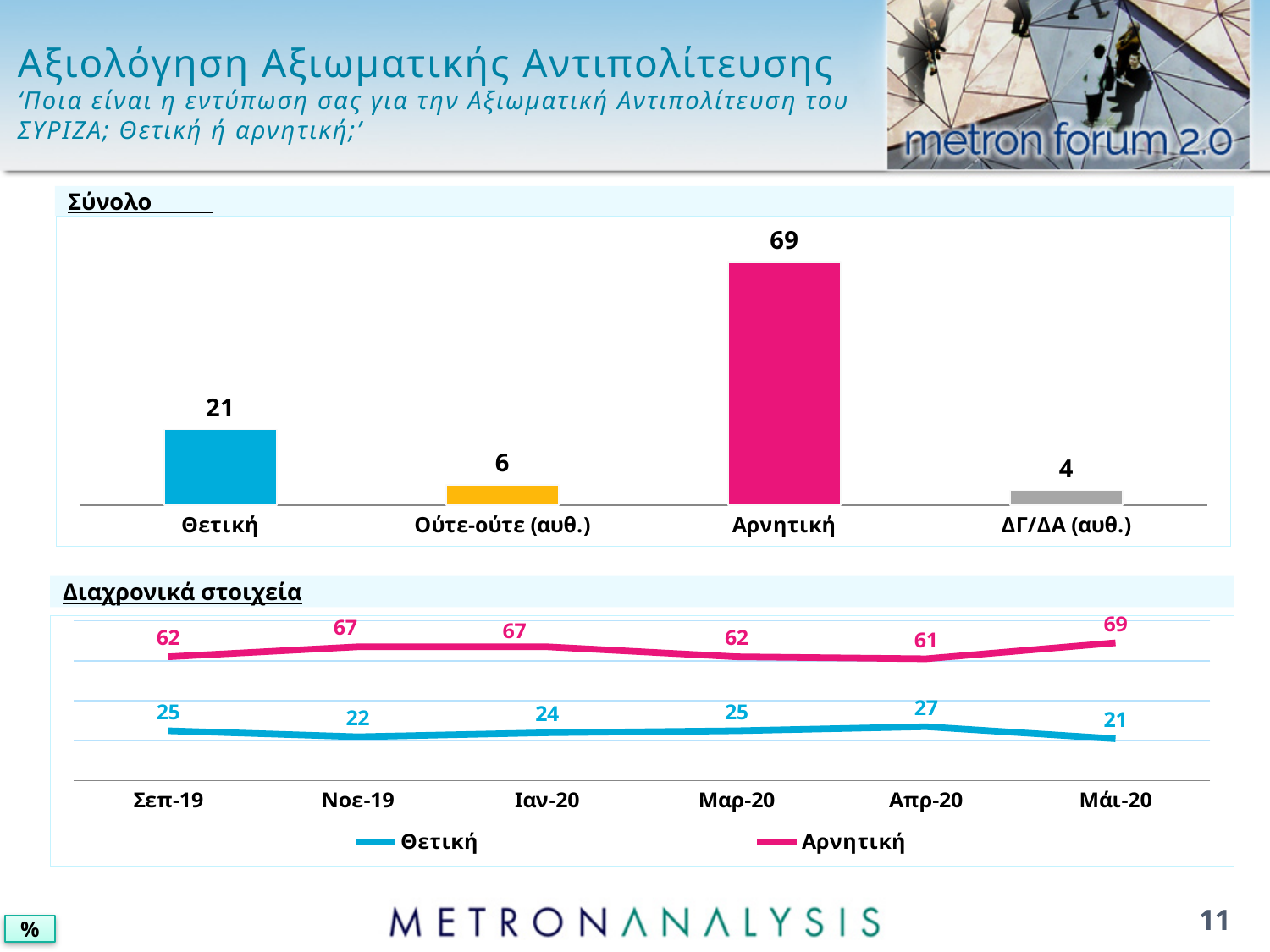
In the 'Διαχρονικά στοιχεία' line chart, what is the value of Θετική for Νοε-19? 22 In the 'Σύνολο' bar chart, which category has the lowest value? ΔΓ/ΔΑ (αυθ.) In the 'Διαχρονικά στοιχεία' line chart, what is the value of Αρνητική for Απρ-20? 61 In the 'Σύνολο' bar chart, what is the value for Αρνητική? 69 In the 'Διαχρονικά στοιχεία' line chart, at which date is Θετική highest? Απρ-20 In the 'Σύνολο' bar chart, what is the difference between Αρνητική and Θετική? 48 In the 'Διαχρονικά στοιχεία' line chart, is Θετική higher in Σεπ-19 or in Μάι-20? Σεπ-19 In the 'Διαχρονικά στοιχεία' line chart, what is the difference between Αρνητική and Θετική in Μαρ-20? 37 In the 'Σύνολο' bar chart, what is the value for Θετική? 21 In the 'Σύνολο' bar chart, how many categories are shown? 4 What kind of chart is the 'Σύνολο' chart? bar chart In the 'Διαχρονικά στοιχεία' line chart, how many series does the legend list? 2